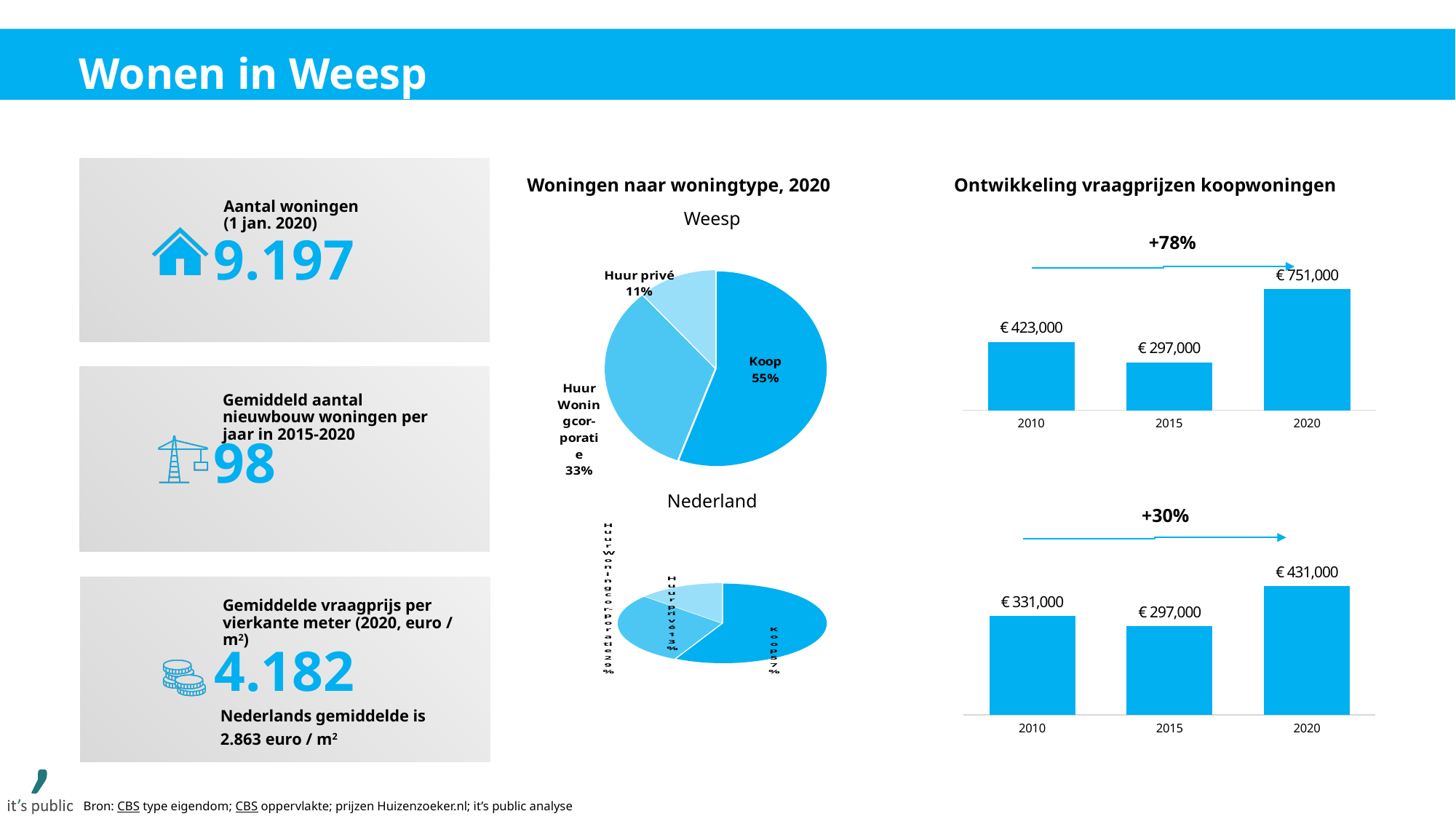
In the lower bar chart on the right, is the value for 2010 larger or smaller than the value for 2015? larger What type of chart is used for 'Ontwikkeling vraagprijzen koopwoningen'? Bar chart How many slices does the Weesp pie chart have? 3 In the upper bar chart on the right, what is the value for 2015? € 297,000 In the lower bar chart on the right, which year has the highest value? 2020 In the Weesp pie chart, which category has the largest slice? Koop In the Weesp pie chart, which category has the smallest slice? Huur privé In the upper bar chart on the right, what is the value for 2020? € 751,000 In the upper bar chart on the right, what is the difference between the 2020 and 2010 values? € 328,000 In the Weesp pie chart, what share of homes is Koop? 55% In the Weesp pie chart, what share of homes is Huur privé? 11% In the lower bar chart on the right, what is the value for 2010? € 331,000